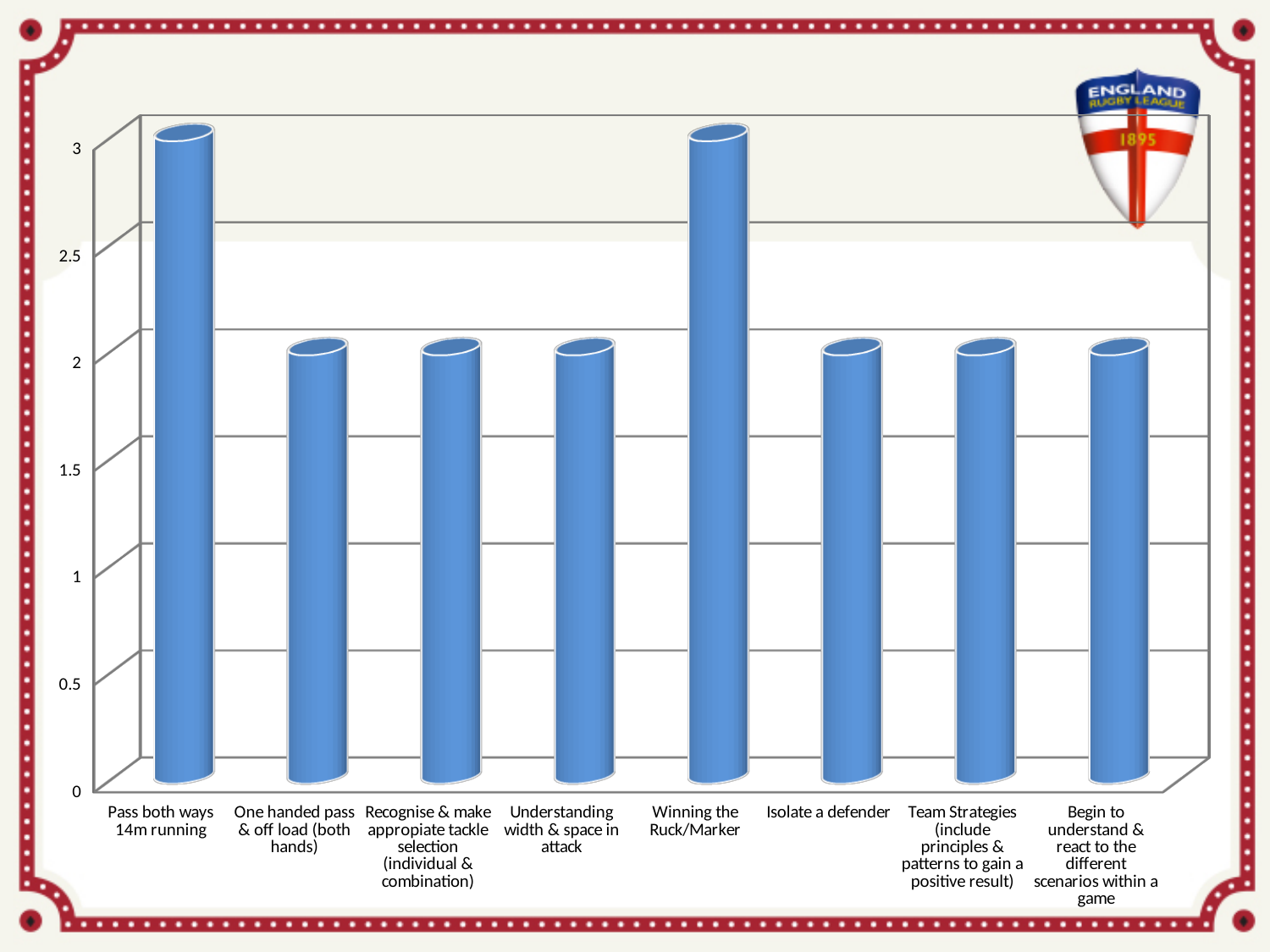
Is the value for 'Winning the Ruck/Marker' greater or less than 2.5? greater Is the value for 'Team Strategies (include principles & patterns to gain a positive result)' greater or less than 2.5? less How many categories are plotted on the chart? 8 How many categories have a value of 3? 2 What is the value for 'Winning the Ruck/Marker'? 3 What is the value for 'Pass both ways 14m running'? 3 What is the value for 'Understanding width & space in attack'? 2 What type of chart is shown on the slide? bar chart What is the difference between the value for 'Pass both ways 14m running' and the value for 'One handed pass & off load (both hands)'? 1 What is the highest value shown on the vertical axis? 3 What is the value for 'Isolate a defender'? 2 Which is larger, the value for 'Winning the Ruck/Marker' or the value for 'Isolate a defender'? Winning the Ruck/Marker